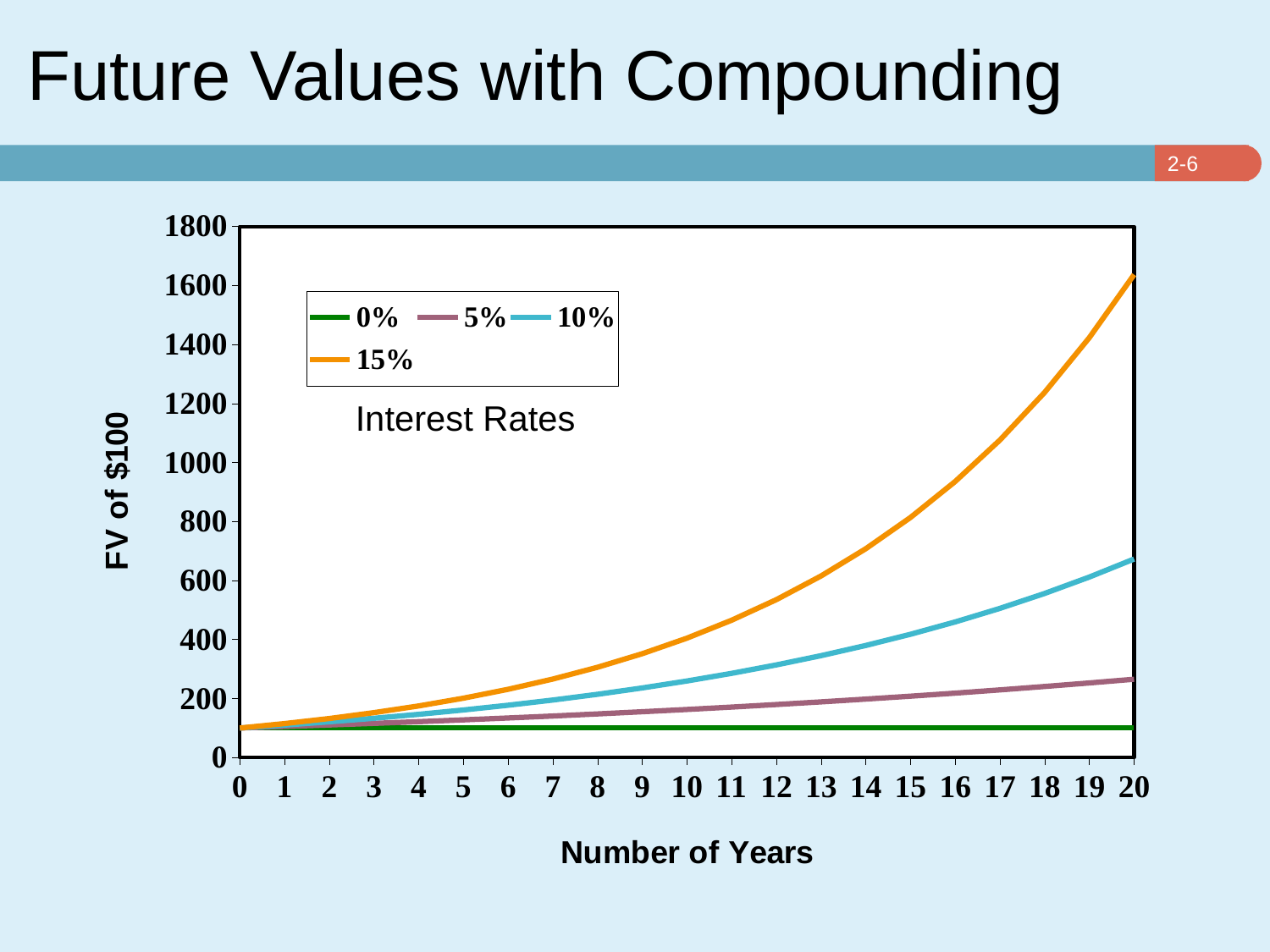
What kind of chart is shown on the slide? line chart How many series does the legend list? 4 What are the entries in the chart's legend? 0%, 5%, 10%, 15% Is the value for the 15% series at year 20 greater or less than 1400? greater How many year labels are shown along the x axis? 21 What is the title of the x axis? Number of Years At year 15, which series has the larger value, 10% or 5%? 10% Is the value for the 10% series at year 20 greater or less than 800? less Is the value for the 5% series at year 20 greater or less than 400? less Which interest rate series has the highest value at year 20? 15% Which interest rate series has the lowest value at year 20? 0% Does the 15% series rise or fall as the number of years increases? rises